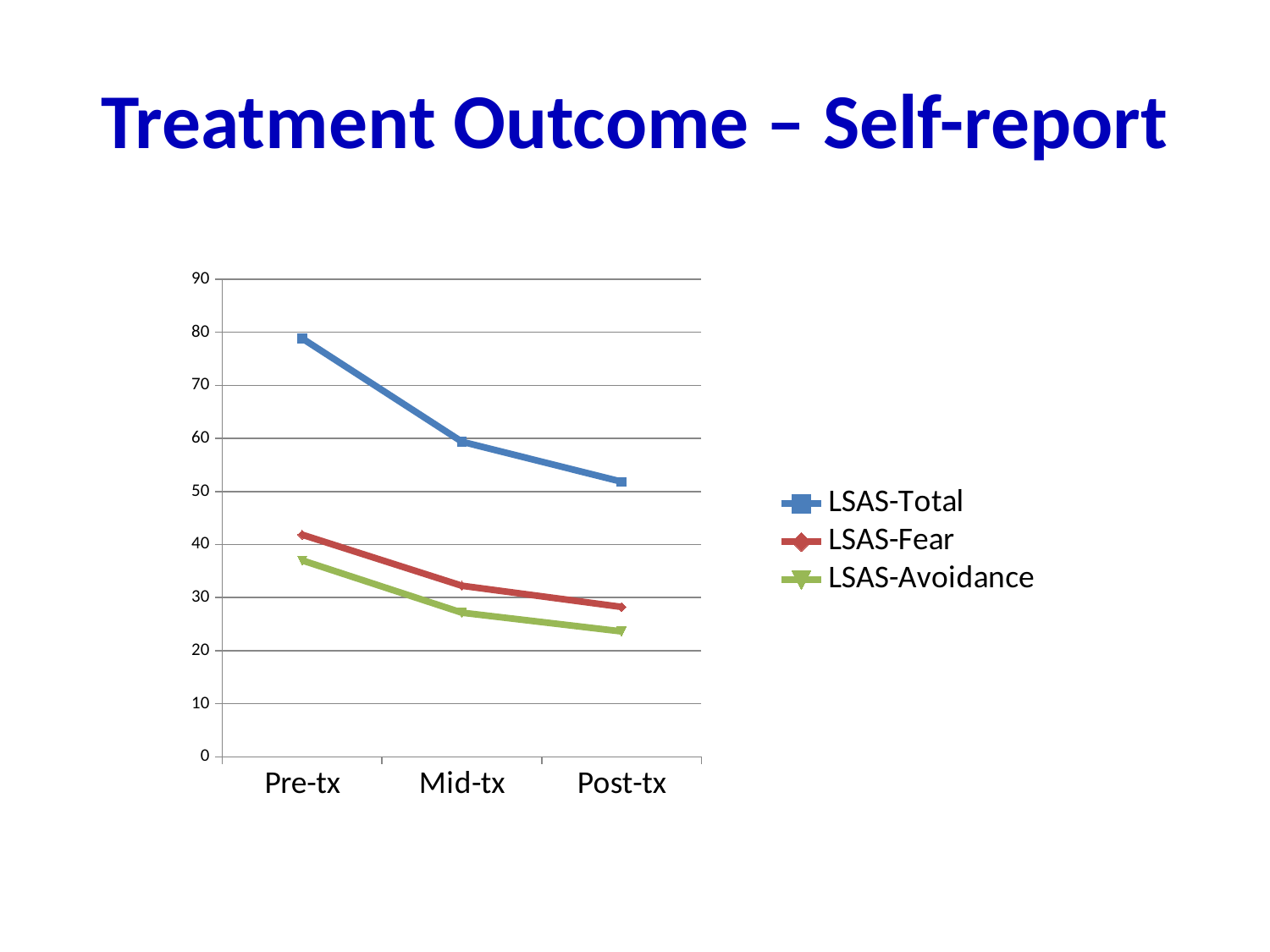
What kind of chart is shown on the slide? line chart Do the LSAS-Total values rise or fall from Pre-tx to Post-tx? fall Is the LSAS-Total value at Pre-tx greater or less than 70? greater Which series has the lowest value at Post-tx? LSAS-Avoidance Is the LSAS-Total value at Post-tx greater or less than 60? less How many series does the legend list? 3 What is the title of the slide? Treatment Outcome – Self-report Which is larger, the LSAS-Fear value at Pre-tx or the LSAS-Fear value at Post-tx? Pre-tx Is the LSAS-Avoidance value at Post-tx greater or less than 30? less Which series has the highest value at Pre-tx? LSAS-Total How many time points are shown on the x axis? 3